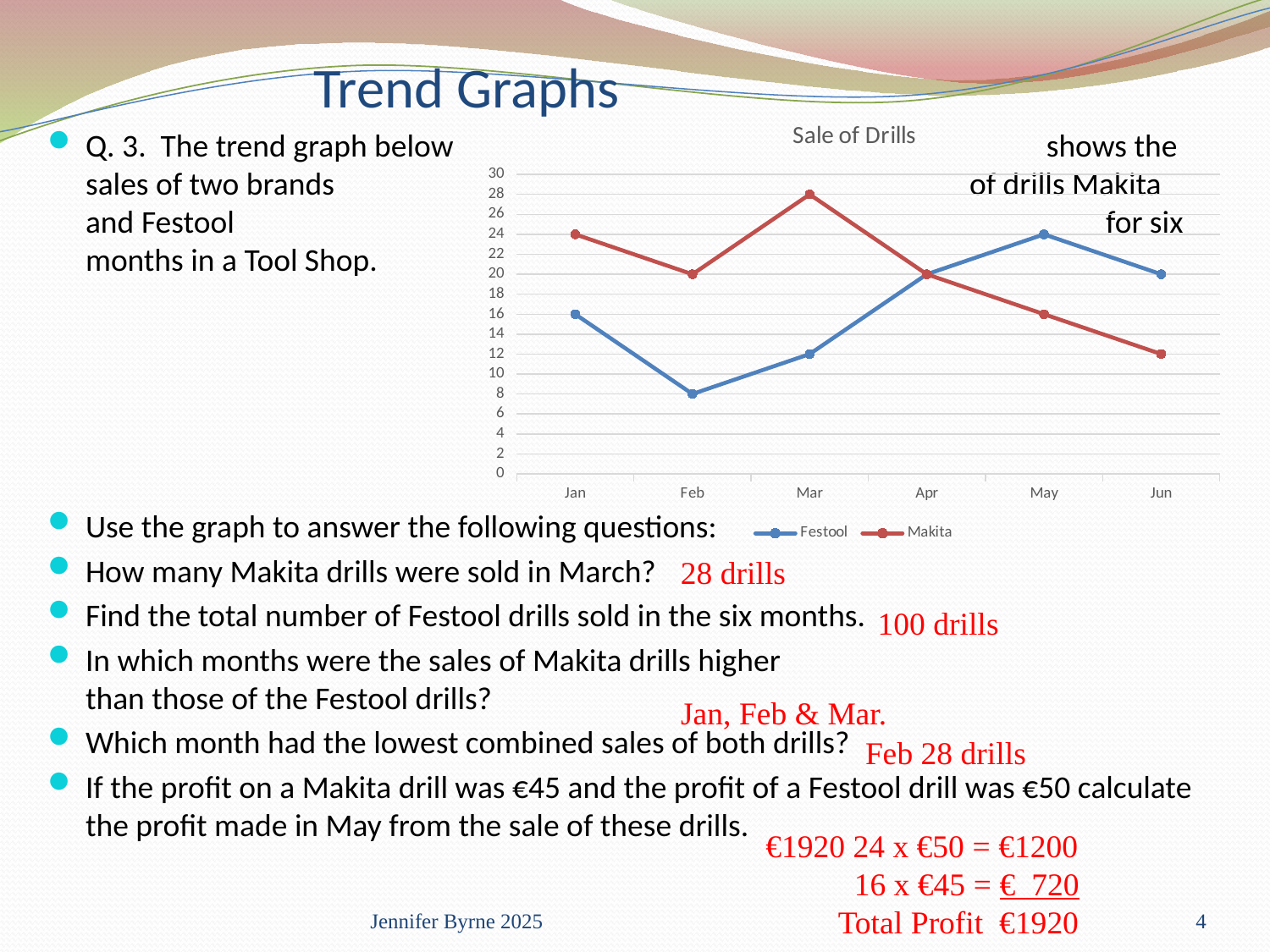
How many Makita drills were sold in March? 28 How many Festool drills were sold in February? 8 In which month were Makita sales highest? Mar What kind of chart is shown on the slide? line chart In January, which brand sold more drills, Festool or Makita? Makita How many series does the legend list? 2 What is the difference between Makita and Festool sales in March? 16 How many months are shown on the x axis? 6 What is the total number of Festool drills sold over the six months? 100 drills Do Makita sales rise or fall from March to June? fall In which month were Festool sales lowest? Feb What is the title of the chart? Sale of Drills